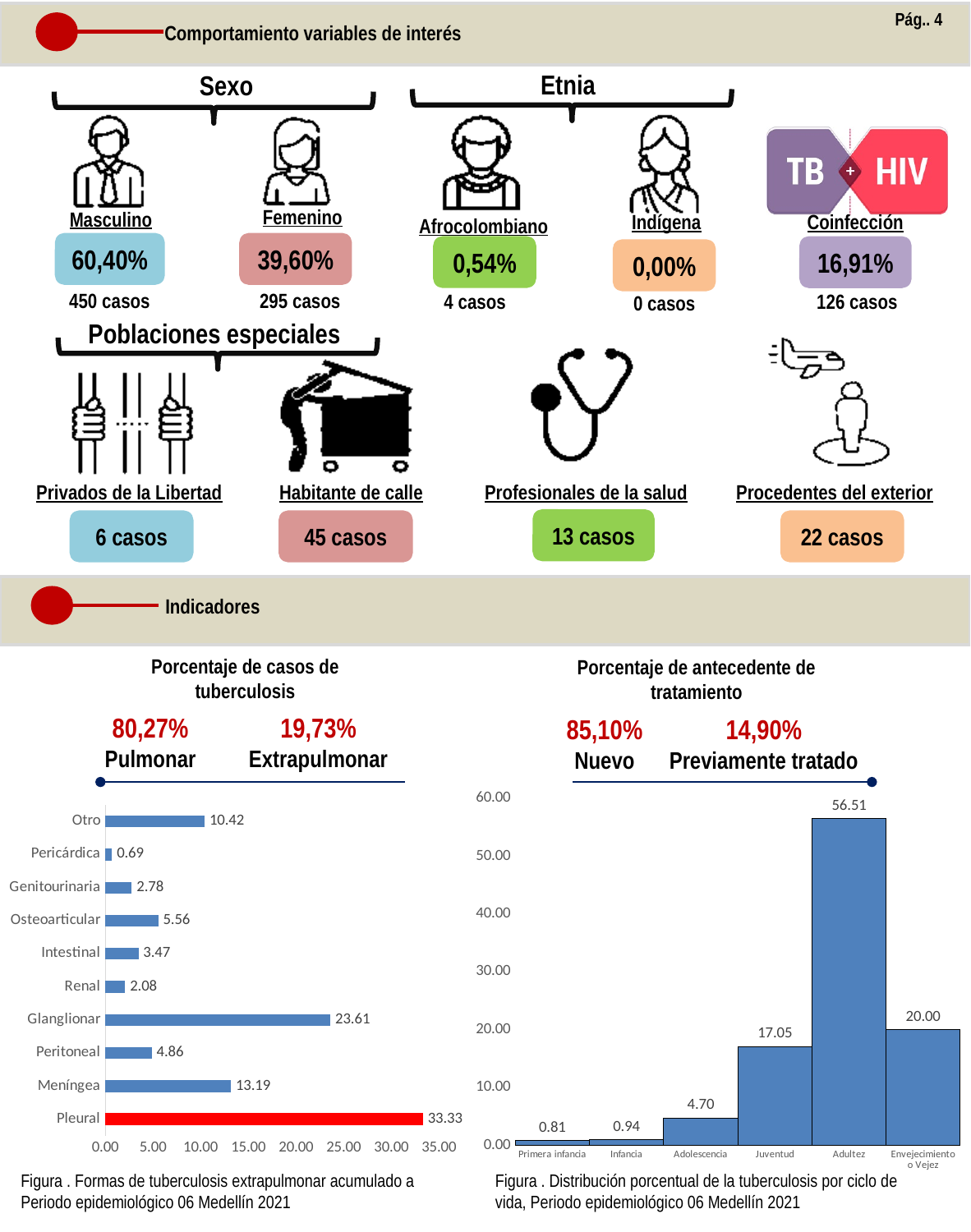
In the left chart (formas de tuberculosis extrapulmonar), how many categories are shown? 10 In the left chart (formas de tuberculosis extrapulmonar), what is the difference between the values for Pleural and Meníngea? 20.14 In the left chart (formas de tuberculosis extrapulmonar), which category has the lowest value? Pericárdica In the left chart (formas de tuberculosis extrapulmonar), which bar is coloured red rather than blue? Pleural In the right chart (distribución por ciclo de vida), what is the value for Adultez? 56.51 In the right chart (distribución por ciclo de vida), what is the difference between Adultez and Envejecimiento o Vejez? 36.51 In the left chart (formas de tuberculosis extrapulmonar), which category has the highest value? Pleural In the right chart (distribución por ciclo de vida), which category has the lowest value? Primera infancia In the right chart (distribución por ciclo de vida), which is larger, Juventud or Envejecimiento o Vejez? Envejecimiento o Vejez In the right chart (distribución por ciclo de vida), what is the value for Juventud? 17.05 In the left chart (formas de tuberculosis extrapulmonar), what is the value for Glanglionar? 23.61 What type of chart is the right chart (distribución por ciclo de vida)? Bar chart